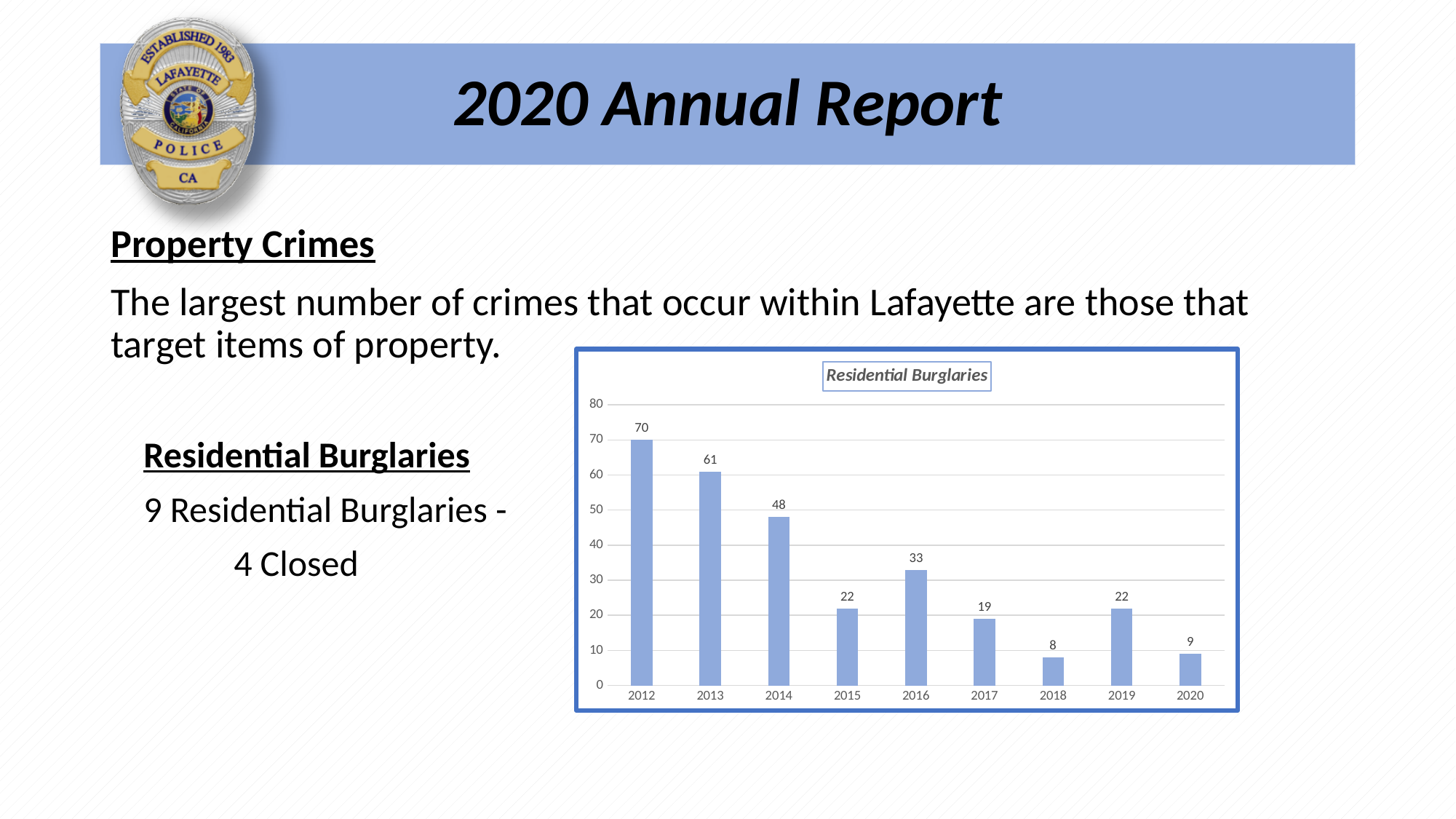
Which year has the lowest number of residential burglaries? 2018 What is the title of the chart? Residential Burglaries Which year has a larger value, 2014 or 2017? 2014 Is the value for 2015 greater or less than 30? less What is the difference between the values for 2019 and 2020? 13 What is the value for 2016 in the Residential Burglaries chart? 33 What kind of chart is used to show Residential Burglaries? bar chart How many residential burglaries are shown for 2020? 9 What is the difference between the values for 2012 and 2013? 9 Which year has the highest number of residential burglaries? 2012 What is the value for 2012 in the Residential Burglaries chart? 70 How many years are shown on the x axis of the chart? 9